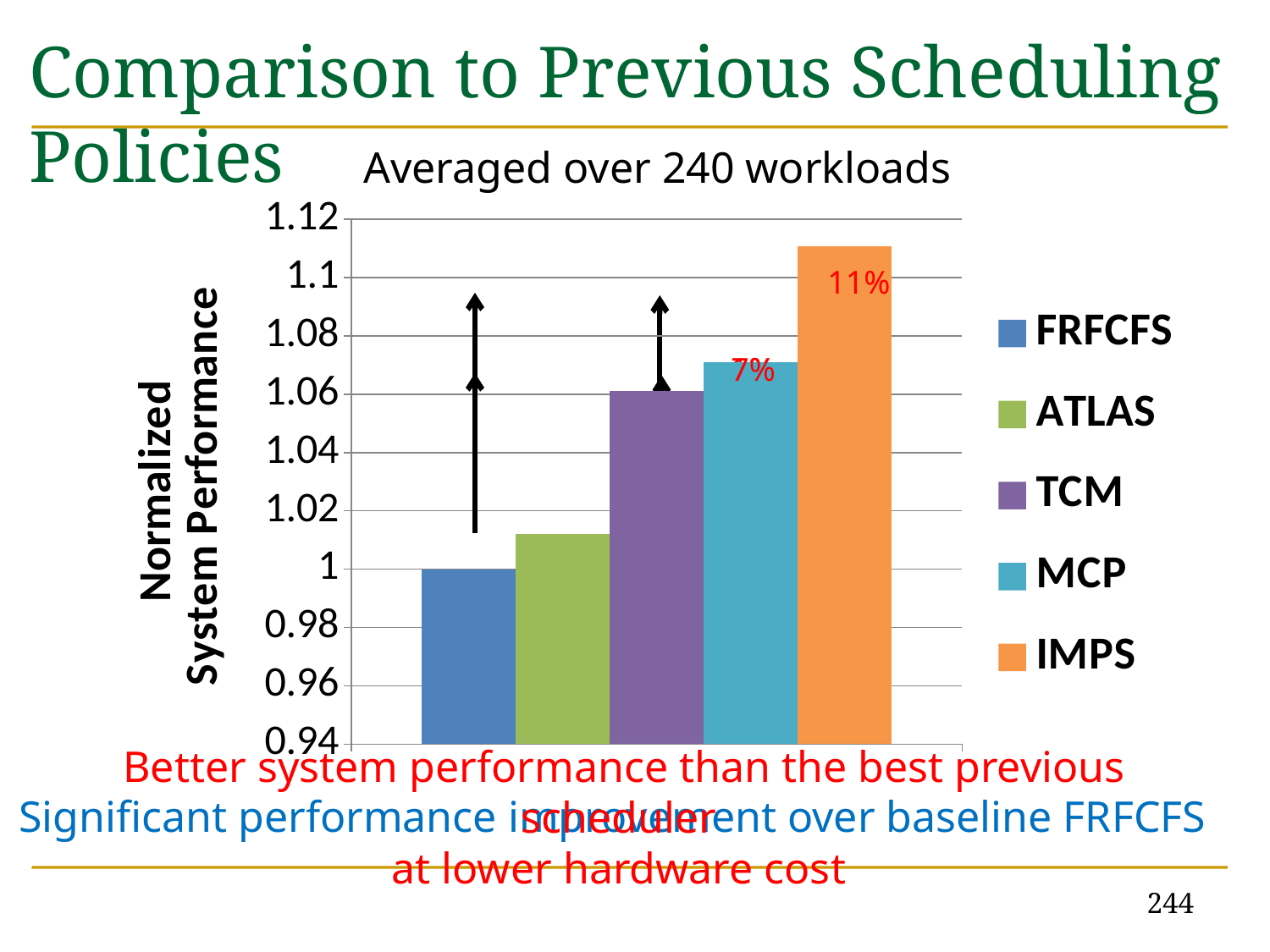
Is the normalized system performance for TCM greater or less than 1.04? greater How many series does the legend list? 5 Which scheduling policy has the highest normalized system performance? IMPS What is the normalized system performance of FRFCFS? 1 Which has a higher normalized system performance, ATLAS or TCM? TCM Is the normalized system performance for ATLAS greater or less than 1.02? less Do the bar values rise or fall from left to right across the chart? rise Is the normalized system performance for IMPS greater or less than 1.1? greater Which scheduling policy has the lowest normalized system performance? FRFCFS Which has a higher normalized system performance, MCP or IMPS? IMPS What kind of chart is shown on the slide? bar chart What is the title of the chart? Averaged over 240 workloads